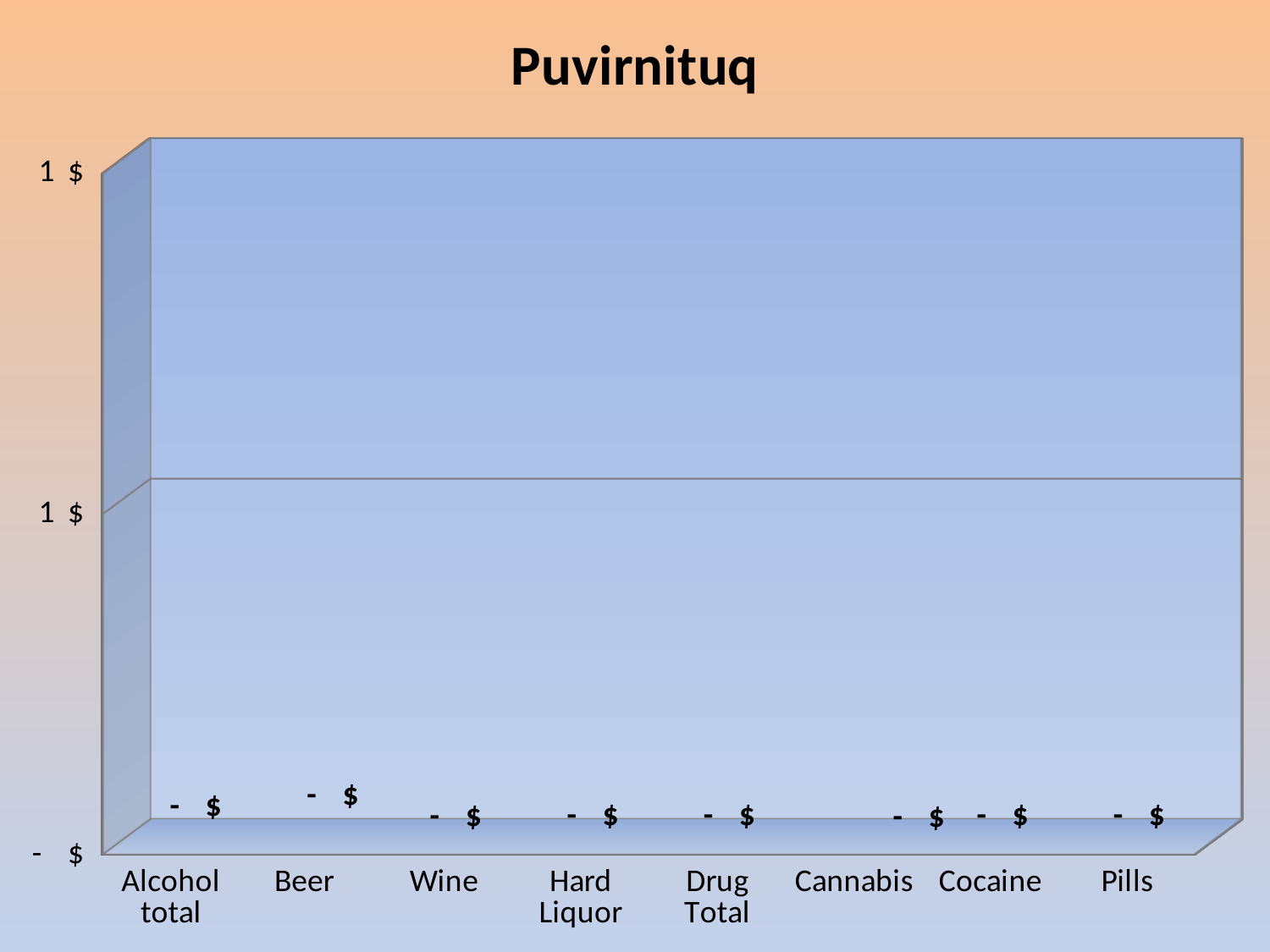
How many categories are shown on the x axis of the chart? 8 What data label is shown for Pills? - $ Is the value for Cocaine greater or less than 1 $? less What is the first category listed on the x axis? Alcohol total What data label is shown for Cannabis? - $ What is the title of the chart? Puvirnituq What data label is shown for Beer? - $ Is the value for Wine greater or less than 1 $? less What data label is shown for Alcohol total? - $ What data label is shown for Drug Total? - $